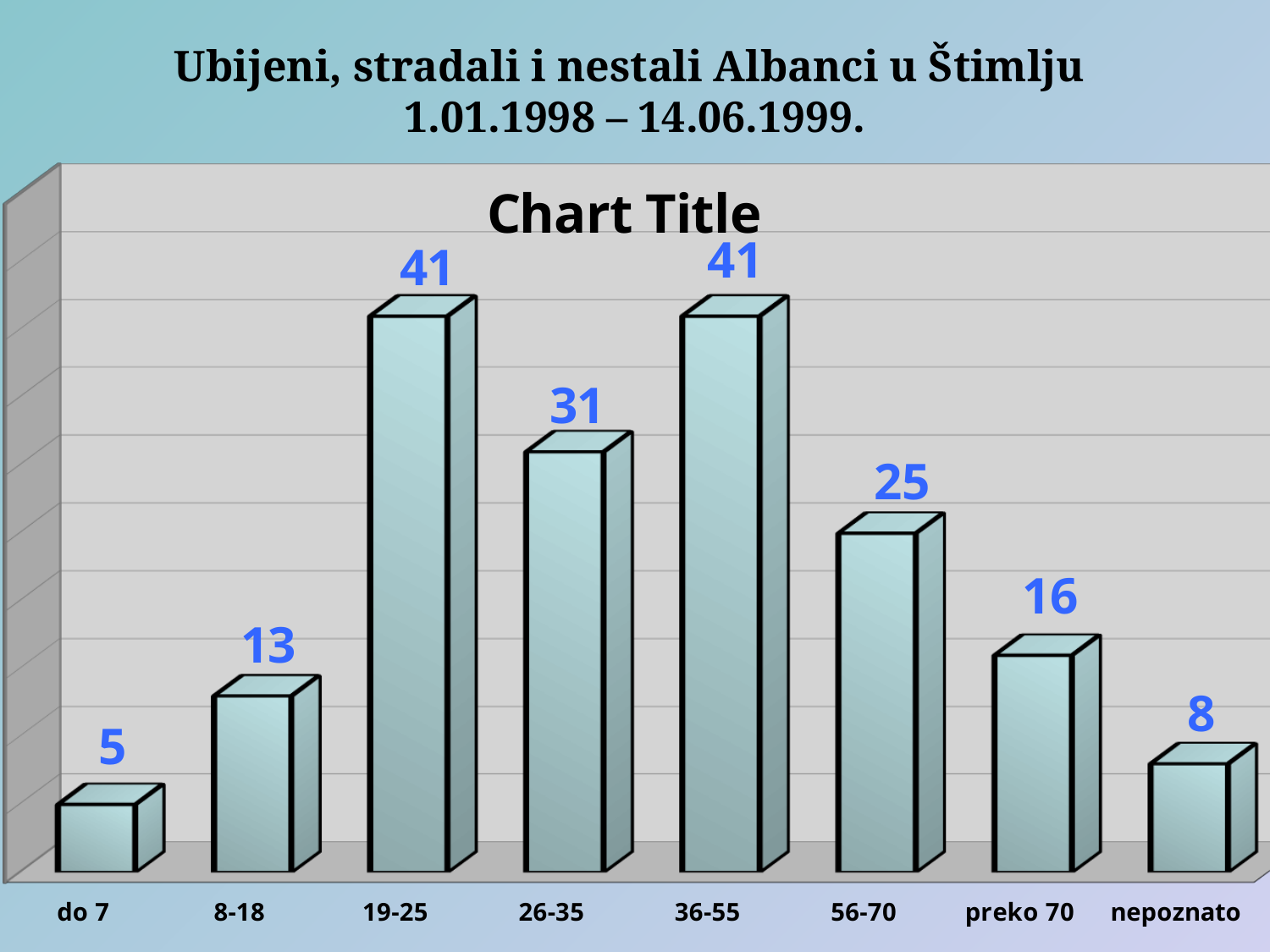
Which category has the lowest value? do 7 Which is larger, the value for 8-18 or the value for nepoznato? 8-18 What is the value for the 19-25 category? 41 What is the value for the do 7 category? 5 Which is larger, the value for 26-35 or the value for 56-70? 26-35 What is the value for the 56-70 category? 25 What is the difference between the values for 26-35 and 8-18? 18 What kind of chart is shown on the slide? bar chart What is the difference between the values for 36-55 and preko 70? 25 How many categories are shown on the x axis? 8 What is the value for the nepoznato category? 8 What is the title printed inside the chart area? Chart Title